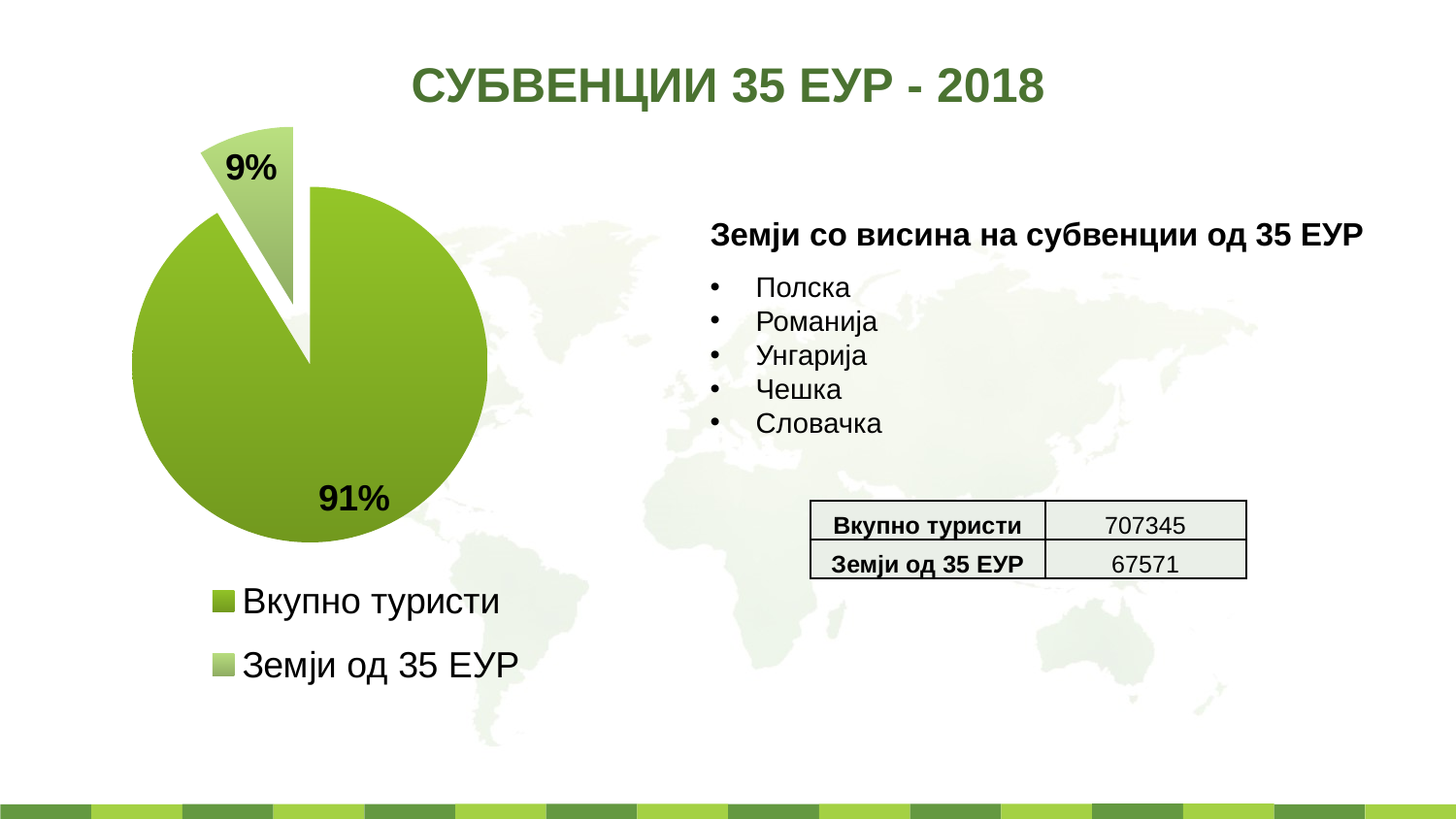
How many slices does the pie chart have? 2 What is the title of the slide containing the pie chart? СУБВЕНЦИИ 35 ЕУР - 2018 What is the difference in percentage points between the Вкупно туристи slice and the Земји од 35 ЕУР slice? 82 Which is larger in the pie chart, the slice for Вкупно туристи or the slice for Земји од 35 ЕУР? Вкупно туристи Which slice of the pie chart is the smallest? Земји од 35 ЕУР What kind of chart is shown on the slide? pie chart How many entries does the legend of the pie chart list? 2 Which slice of the pie chart is the largest? Вкупно туристи What share of the pie does the slice for Вкупно туристи represent? 91% Which legend entry is shown in the lighter green colour in the pie chart? Земји од 35 ЕУР What share of the pie does the slice for Земји од 35 ЕУР represent? 9%